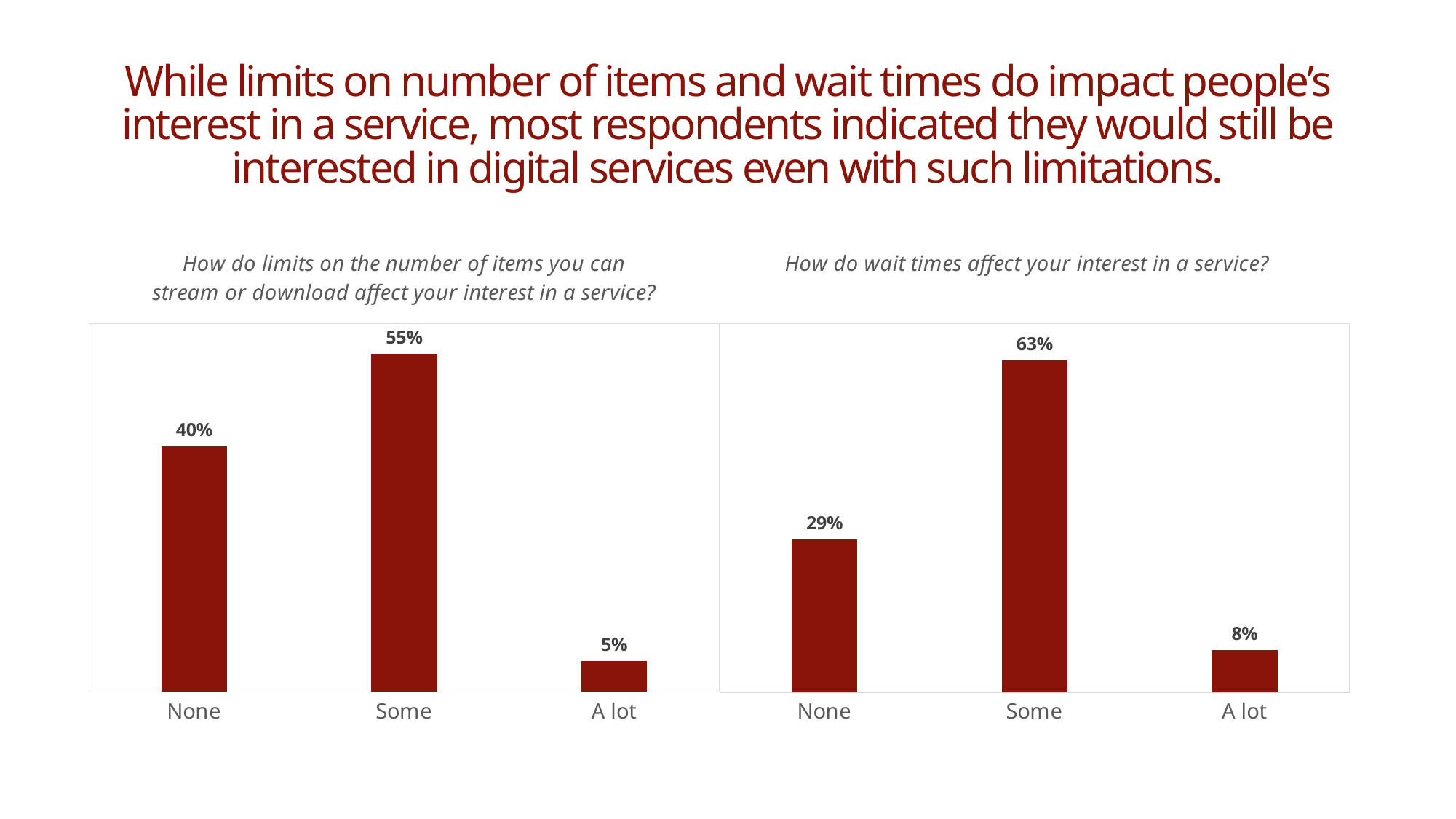
In the right chart (wait times), what is the difference between the values for "Some" and "A lot"? 55% In the right chart (wait times), what is the value for "None"? 29% In the left chart (limits on number of items), what is the difference between the values for "Some" and "None"? 15% In the right chart (wait times), which category has the highest value? Some In the left chart (limits on number of items), what is the value for "Some"? 55% In the right chart (wait times), what is the value for "A lot"? 8% What is the title of the right chart? How do wait times affect your interest in a service? In the left chart (limits on number of items), what is the value for "None"? 40% Which is larger: the value for "None" in the left chart or the value for "None" in the right chart? Left chart (40%) In the left chart (limits on number of items), which category has the lowest value? A lot How many categories are shown in the right chart (wait times)? 3 What kind of chart is the left chart (limits on number of items)? Bar chart